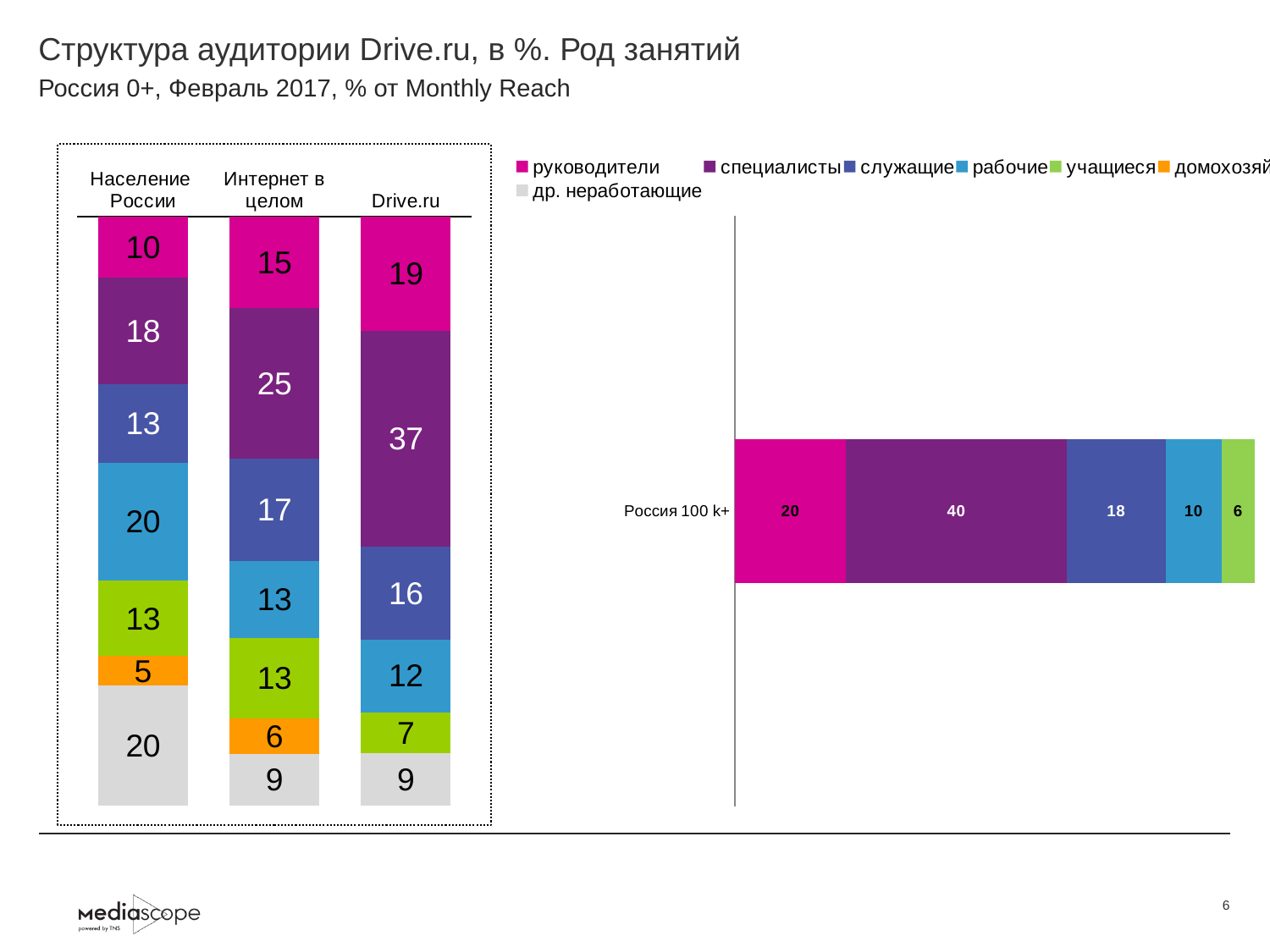
In the left chart, what is the value for рабочие in the Интернет в целом column? 13 In the right chart (Россия 100 k+), what is the value for специалисты? 40 In the left chart, what is the value for специалисты in the Drive.ru column? 37 In the left chart, what is the value for руководители in the Население России column? 10 In the right chart (Россия 100 k+), what is the value for учащиеся? 6 How many columns (categories) are shown in the left chart? 3 How many series does the legend list? 7 In the left chart, which column has the highest value for специалисты? Drive.ru What type of chart is the right chart (Россия 100 k+)? Stacked bar chart In the left chart, which is larger: рабочие for Население России or рабочие for Drive.ru? Население России In the left chart, which column has the lowest value for учащиеся? Drive.ru In the left chart, what is the difference between the руководители values for Drive.ru and Население России? 9